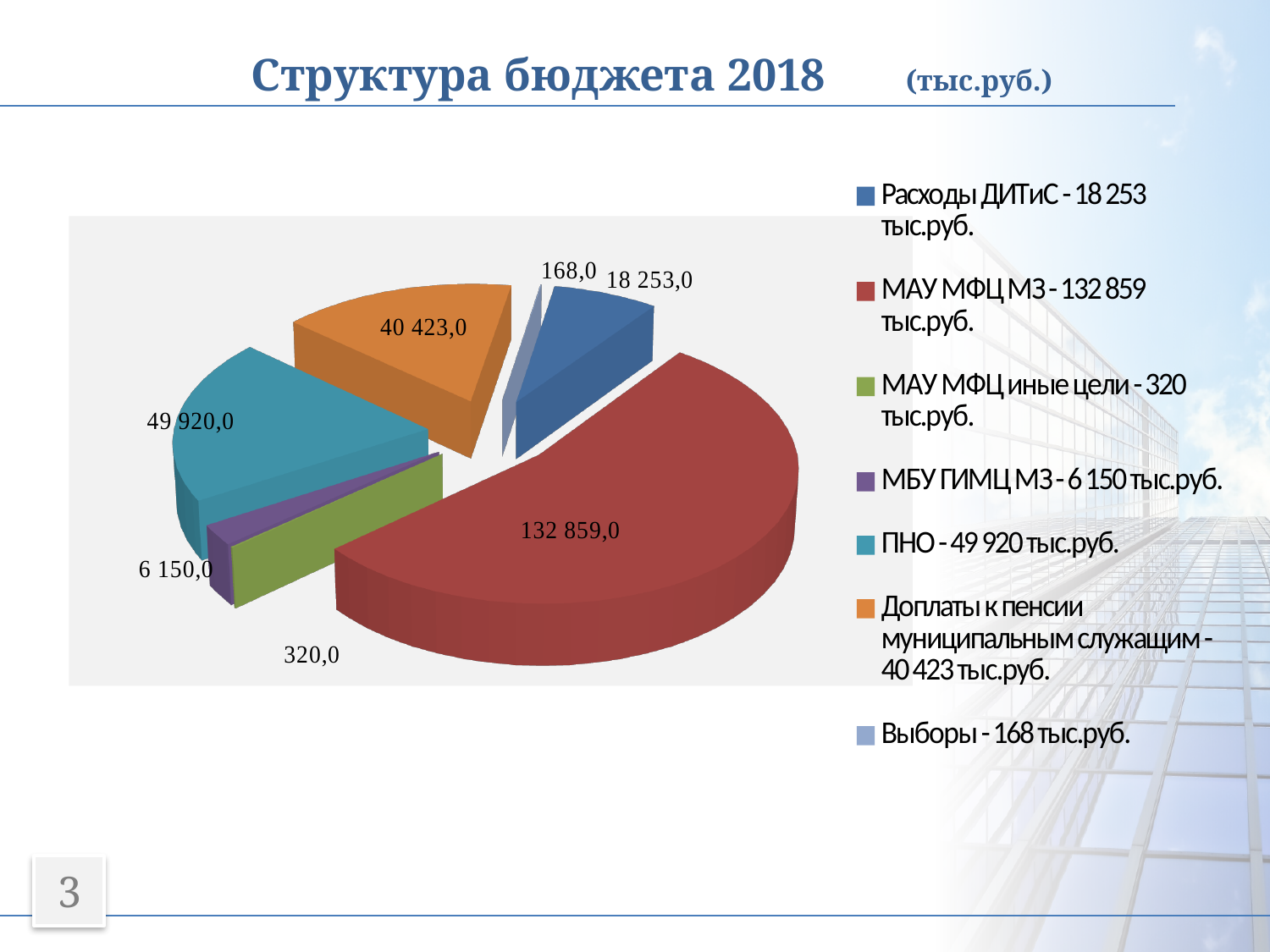
What is the value shown for ПНО? 49 920,0 Which category has the largest slice of the pie? МАУ МФЦ МЗ Which category has the smallest slice of the pie? Выборы How many entries does the legend list? 7 What is the value shown for Выборы? 168,0 Which is larger, the value for ПНО or the value for Доплаты к пенсии муниципальным служащим? ПНО What kind of chart is shown on the slide? pie chart What is the title of the chart on the slide? Структура бюджета 2018 (тыс.руб.) How many slices does the pie chart have? 7 What is the value shown for МАУ МФЦ МЗ? 132 859,0 What is the difference between the value for МАУ МФЦ МЗ and the value for ПНО? 82 939,0 What is the difference between the value for Расходы ДИТиС and the value for МБУ ГИМЦ МЗ? 12 103,0